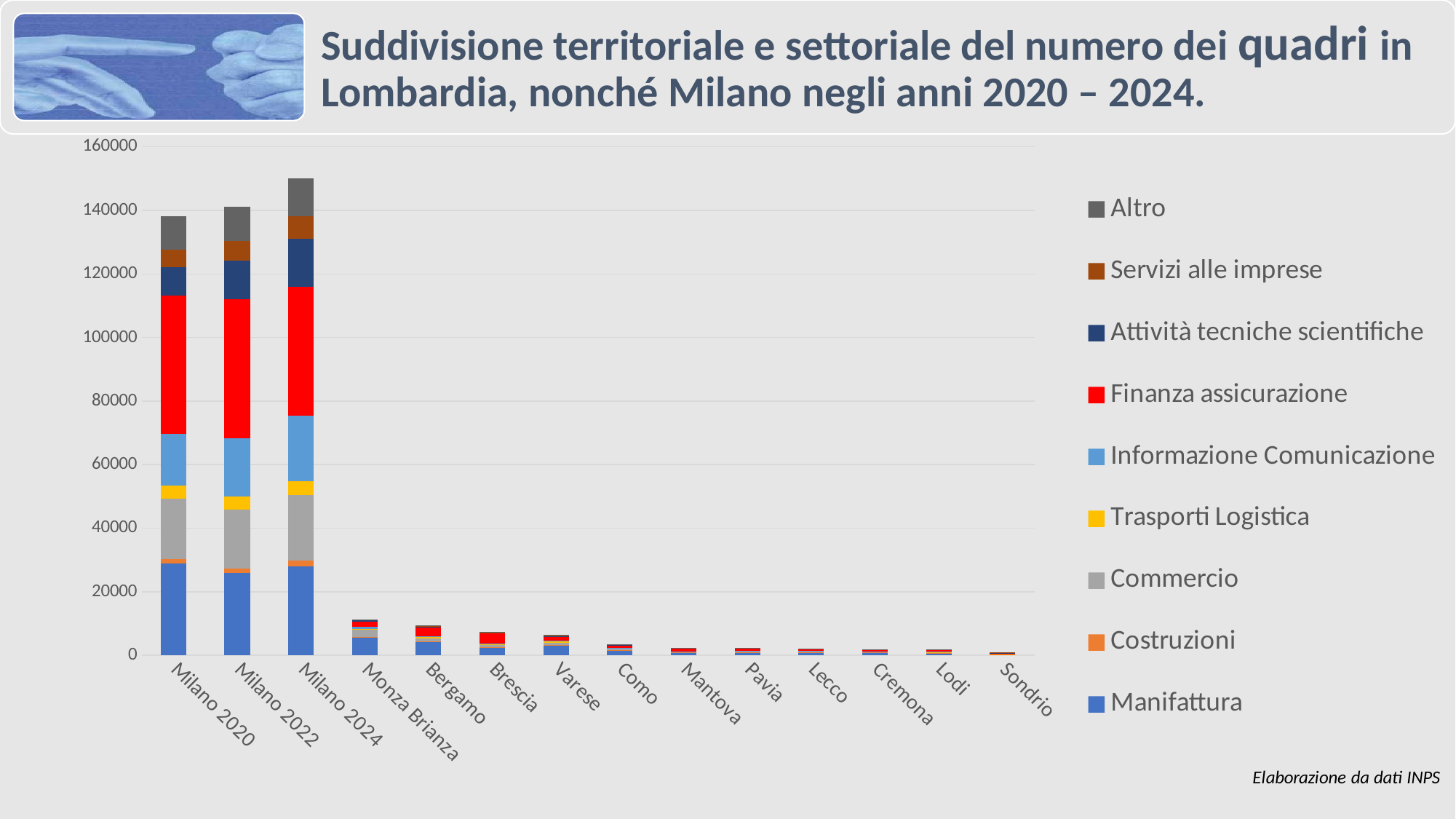
Which category has the lowest total bar? Sondrio How many series does the legend list? 9 How many categories are shown along the x axis of the chart? 14 What kind of chart is shown on the slide? Stacked bar chart Is the total for Milano 2024 greater or less than 140000? greater Is the total for Monza Brianza greater or less than 20000? less Which series is shown in red in the legend? Finanza assicurazione Which category has the highest total bar? Milano 2024 Which has the larger total bar, Milano 2024 or Milano 2020? Milano 2024 Which has the larger total bar, Monza Brianza or Varese? Monza Brianza Do the Milano totals rise or fall from 2020 to 2024? rise Is the total for Milano 2020 greater or less than 120000? greater